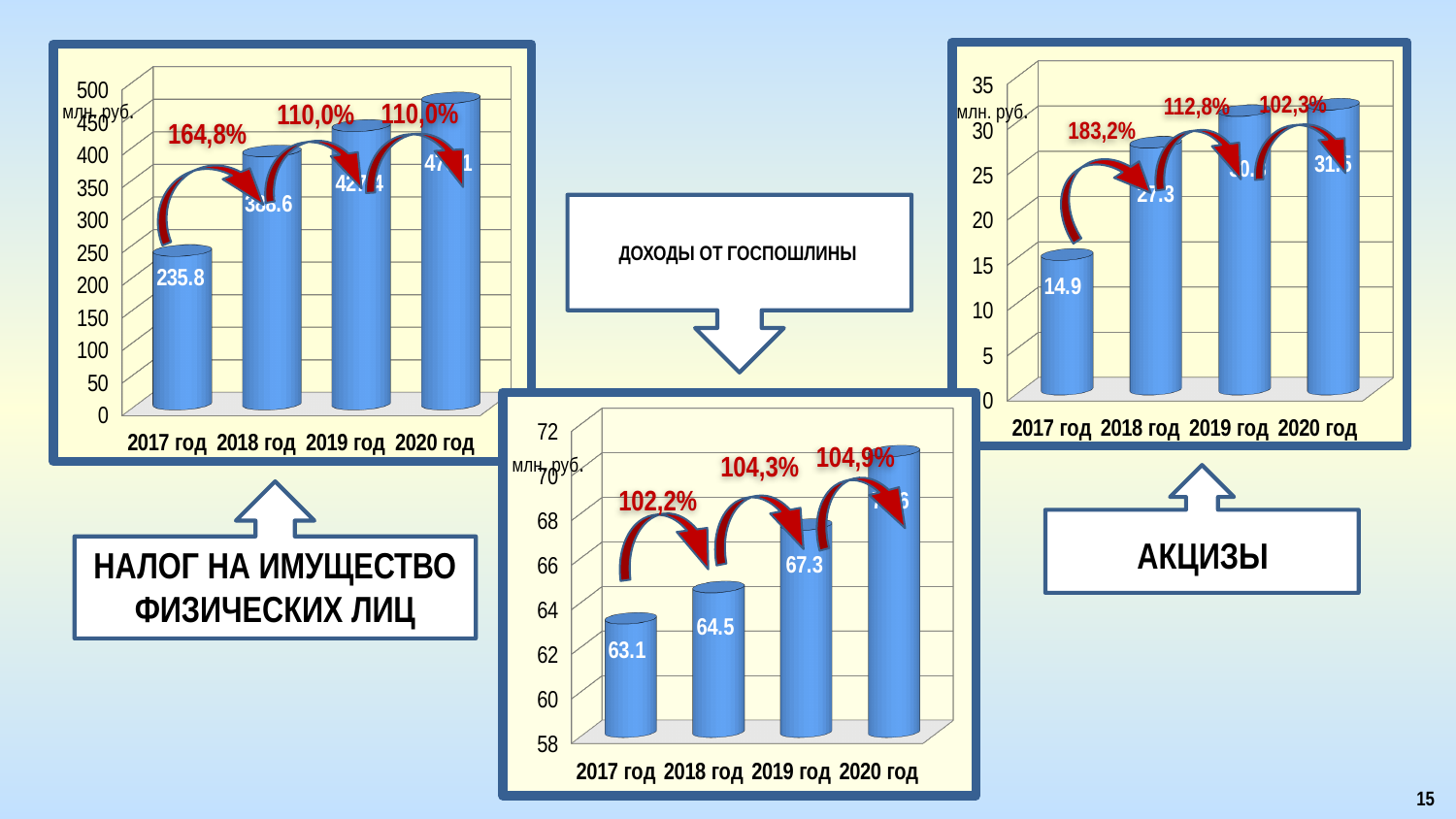
In the chart labelled АКЦИЗЫ, what is the difference between the values for 2018 год and 2017 год? 12.4 In the chart labelled НАЛОГ НА ИМУЩЕСТВО ФИЗИЧЕСКИХ ЛИЦ, is the value for 2020 год greater or less than 450? greater In the chart labelled ДОХОДЫ ОТ ГОСПОШЛИНЫ, do the values rise or fall from 2017 год to 2020 год? rise In the chart labelled АКЦИЗЫ, what is the value for 2017 год? 14.9 In the chart labelled АКЦИЗЫ, which year has the highest value? 2020 год In the chart labelled ДОХОДЫ ОТ ГОСПОШЛИНЫ, what is the value for 2018 год? 64.5 In the chart labelled ДОХОДЫ ОТ ГОСПОШЛИНЫ, what is the difference between the values for 2019 год and 2017 год? 4.2 In the chart labelled НАЛОГ НА ИМУЩЕСТВО ФИЗИЧЕСКИХ ЛИЦ, what is the value for 2017 год? 235.8 In the chart labelled АКЦИЗЫ, what is the value for 2020 год? 31.5 In the chart labelled АКЦИЗЫ, what growth percentage is shown between 2017 год and 2018 год? 183,2% In the chart labelled ДОХОДЫ ОТ ГОСПОШЛИНЫ, what is the value for 2019 год? 67.3 In the chart labelled НАЛОГ НА ИМУЩЕСТВО ФИЗИЧЕСКИХ ЛИЦ, which year has the lowest value? 2017 год